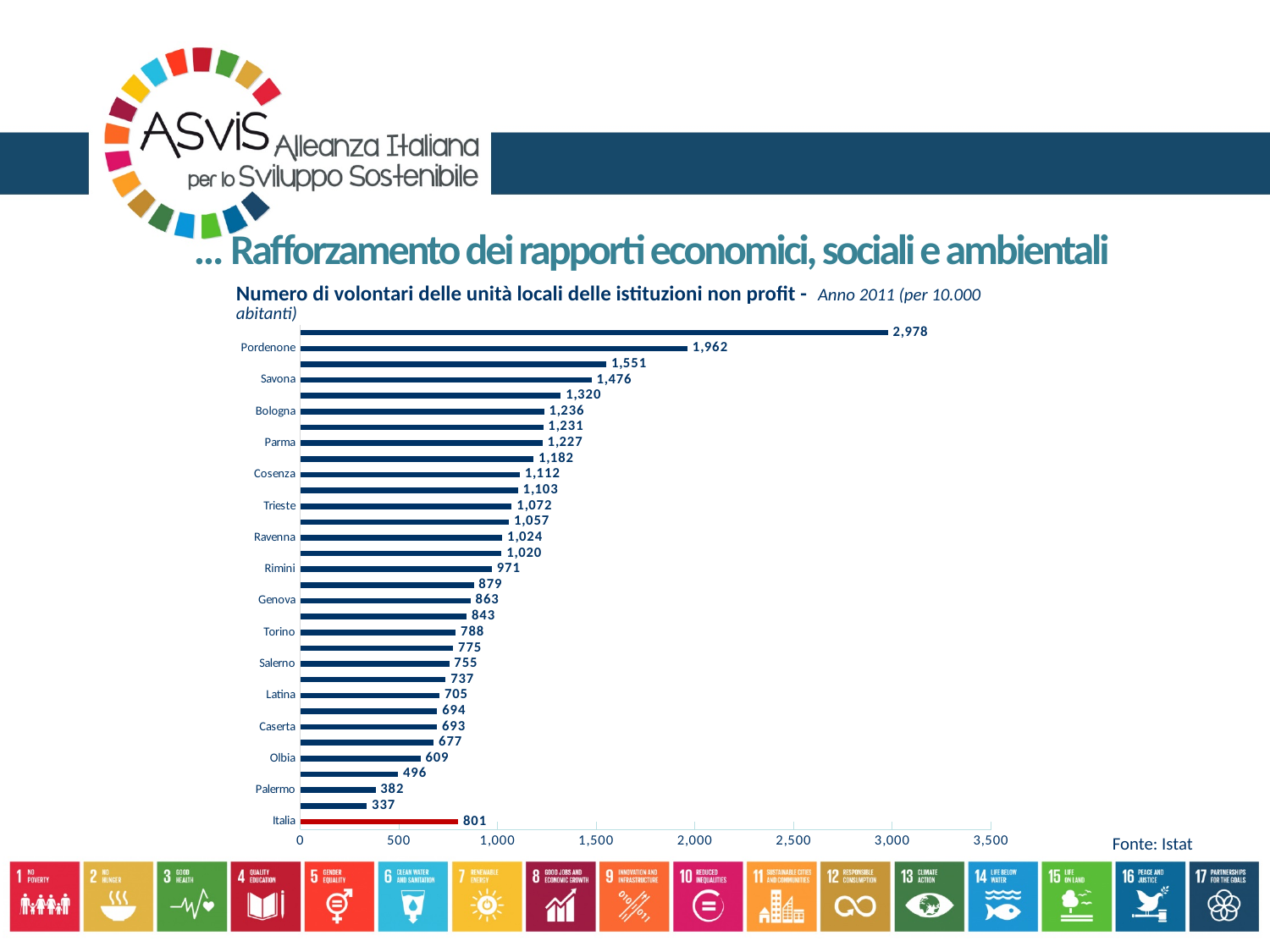
What is the value for Torino? 788 What is the value for Italia? 801 Which is larger, the value for Genova or the value for Torino? Genova What is the highest value plotted in the chart? 2,978 Is the value for Savona greater or less than 1,000? greater What colour is the bar for Italia? red What kind of chart is shown on the slide? bar chart What is the difference between the values for Italia and Palermo? 419 How many bars are plotted in the chart? 32 What is the value for Pordenone? 1,962 What is the value for Palermo? 382 What is the lowest value plotted in the chart? 337